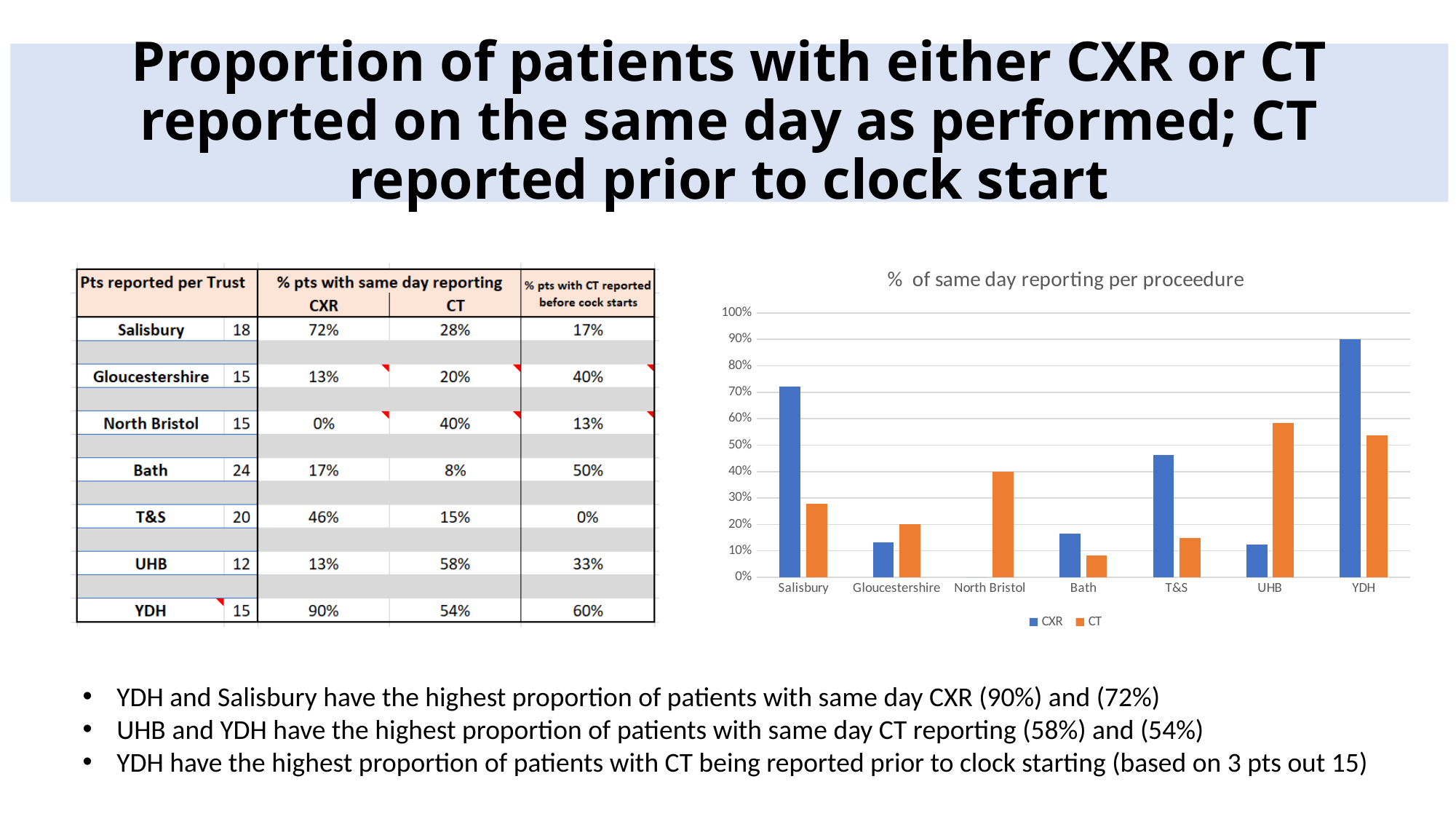
Is the CT value for North Bristol greater or less than 50%? less For UHB, which is larger, the CXR value or the CT value? CT How many series does the chart legend list? 2 Which trust has the highest CXR same-day reporting value in the chart? YDH What is the title of the chart? % of same day reporting per proceedure Is the CXR value for Salisbury greater or less than 70%? greater Which trust has the lowest CT same-day reporting value in the chart? Bath What type of chart is shown on the slide? bar chart What is the CXR same-day reporting value for YDH? 90% Which trust has the highest CT same-day reporting value in the chart? UHB What is the CT same-day reporting value for Salisbury? 28% How many trusts are shown along the x axis of the chart? 7